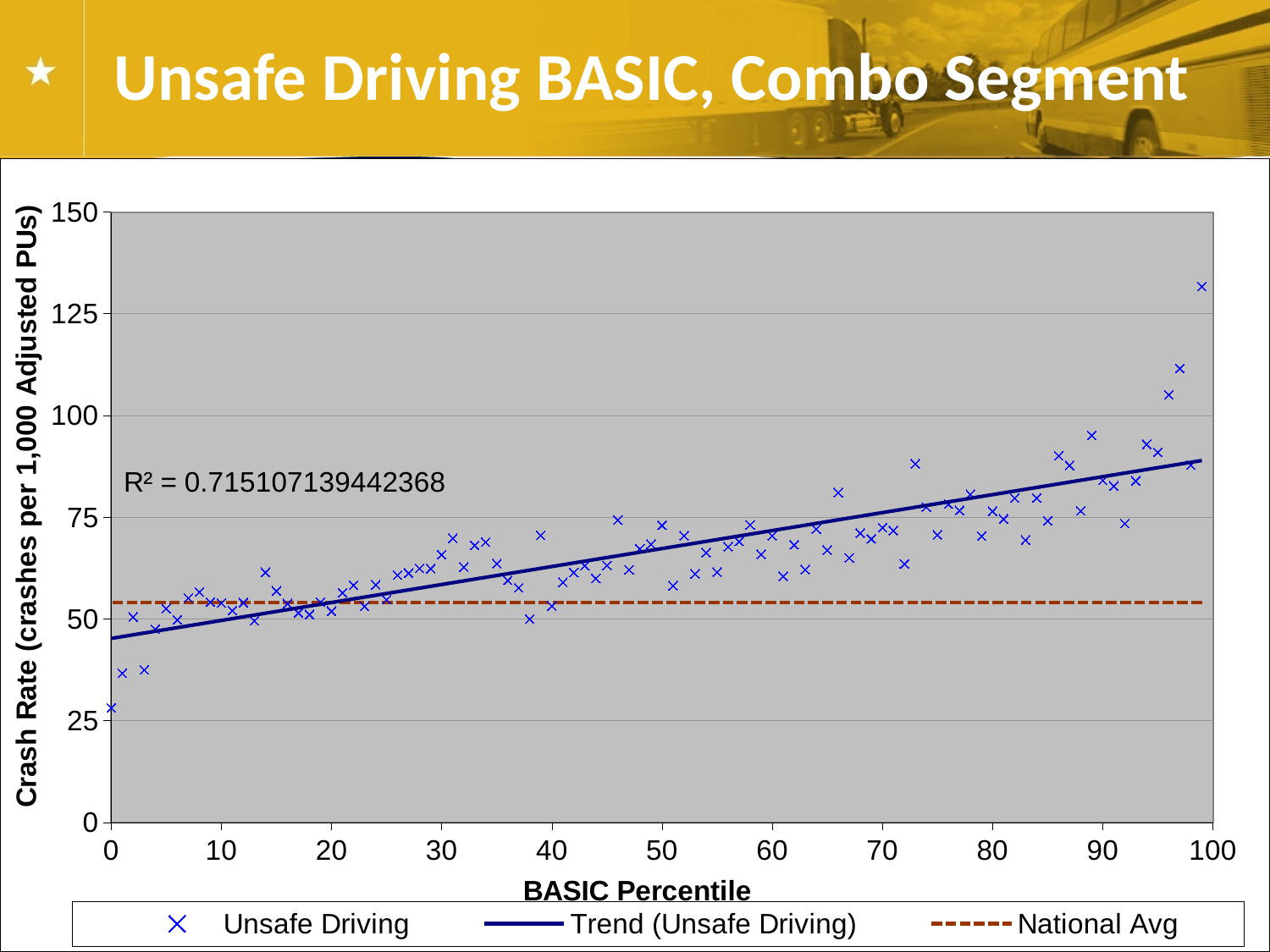
Is the National Avg line greater or less than 75 crashes per 1,000 Adjusted PUs? less What is the R² value printed on the chart? R² = 0.715107139442368 Is the Unsafe Driving data point at BASIC Percentile 0 greater or less than 50? less Is the National Avg line greater or less than 50 crashes per 1,000 Adjusted PUs? greater Does the crash rate generally rise or fall as the BASIC Percentile increases along the x axis? rise How many series does the legend list? 3 What are the three entries in the chart legend? Unsafe Driving, Trend (Unsafe Driving), National Avg What kind of chart is shown on the slide? scatter chart What is the title of the slide containing the chart? Unsafe Driving BASIC, Combo Segment What is the label of the x axis? BASIC Percentile